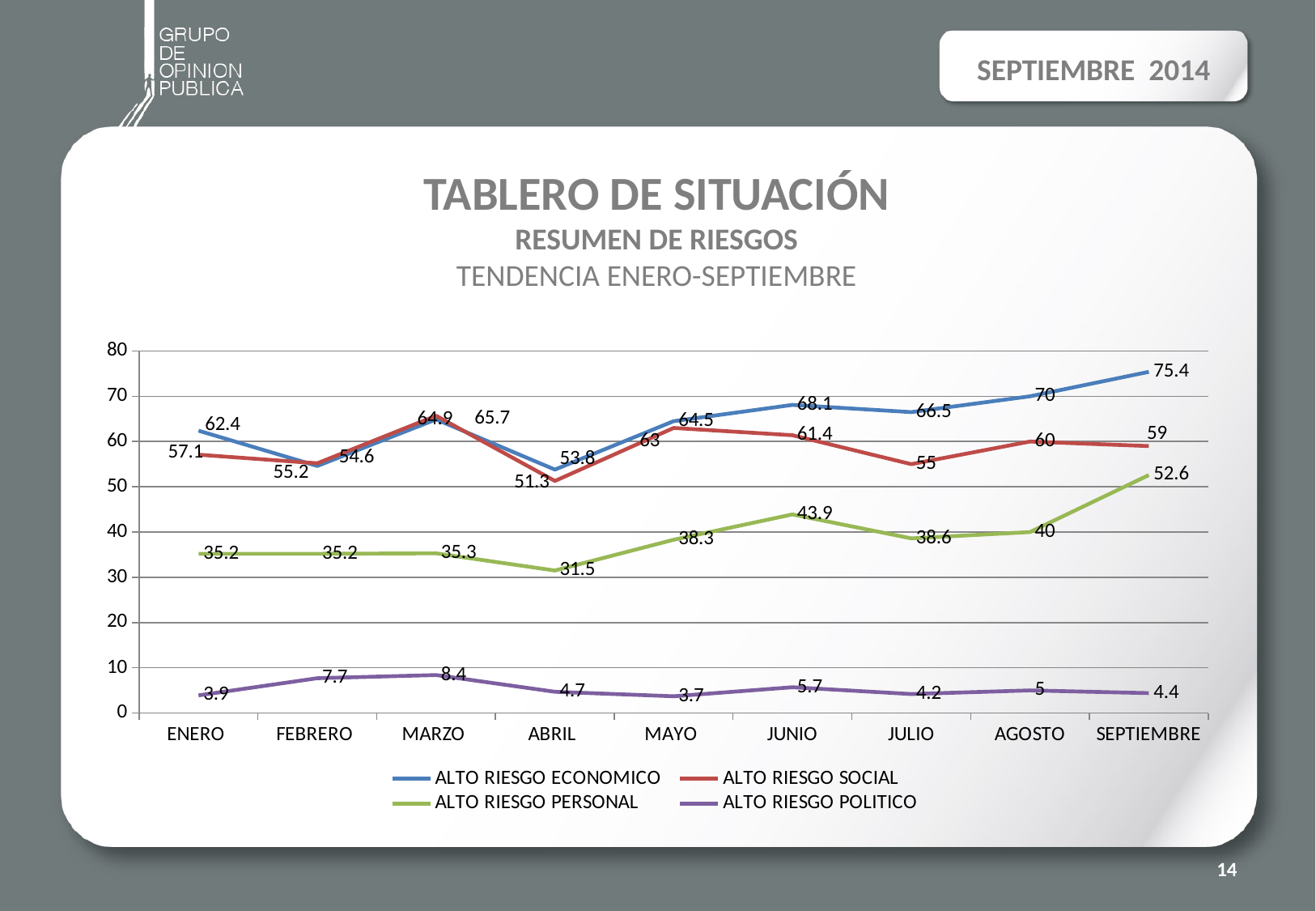
What is the value for ALTO RIESGO SOCIAL in ENERO? 57.1 Which is larger in JUNIO, ALTO RIESGO ECONOMICO or ALTO RIESGO SOCIAL? ALTO RIESGO ECONOMICO What is the difference between the ALTO RIESGO ECONOMICO values in SEPTIEMBRE and ENERO? 13 What is the value for ALTO RIESGO ECONOMICO in SEPTIEMBRE? 75.4 In which month is ALTO RIESGO PERSONAL at its lowest? ABRIL What kind of chart is shown on the slide? Line chart In which month does ALTO RIESGO ECONOMICO reach its highest value? SEPTIEMBRE How many months are shown on the x axis? 9 What is the value for ALTO RIESGO POLITICO in MARZO? 8.4 How many series does the legend list? 4 What is the value for ALTO RIESGO PERSONAL in ABRIL? 31.5 Is the value for ALTO RIESGO POLITICO in FEBRERO greater or less than 10? less